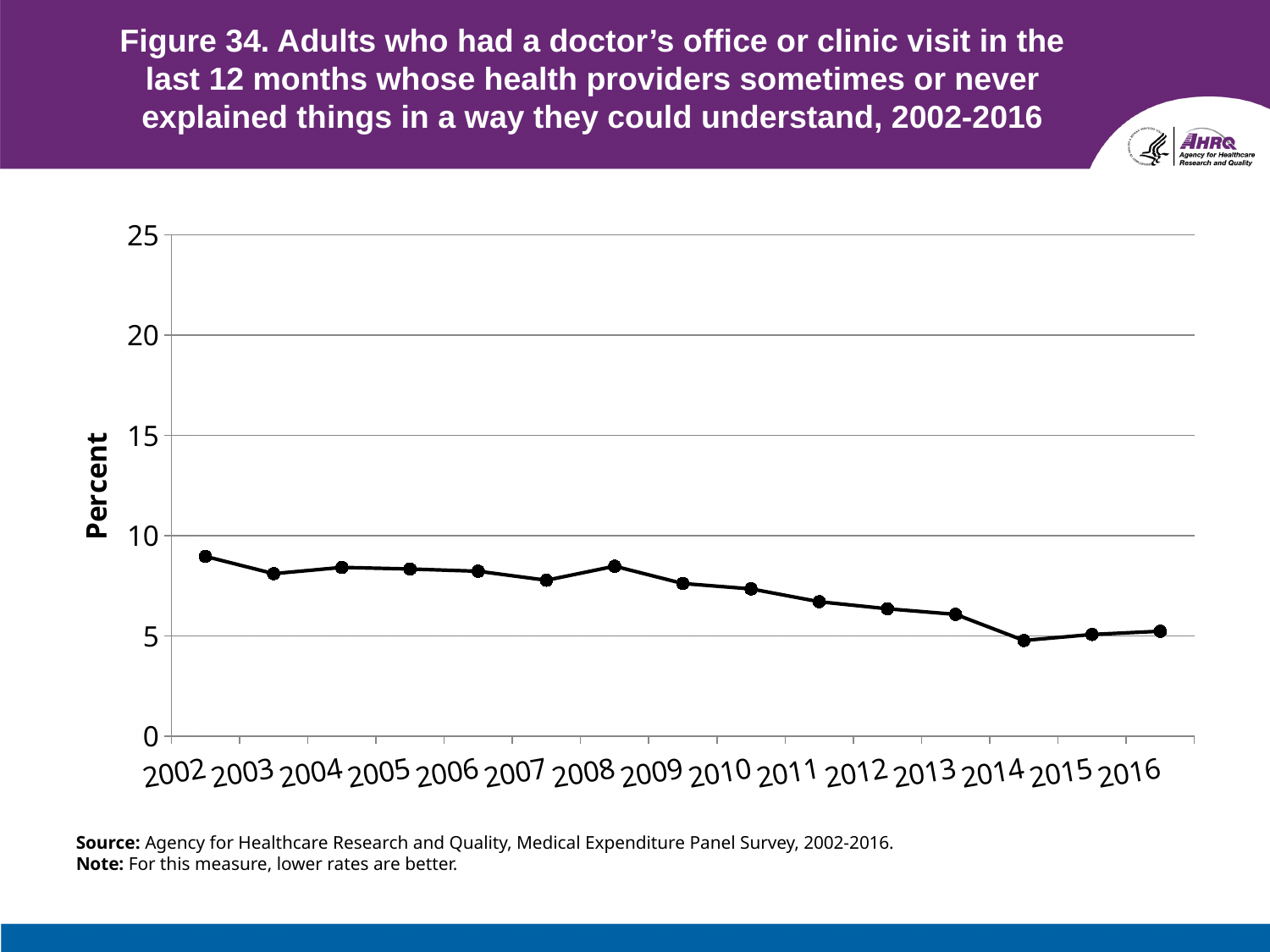
What is the first year shown on the horizontal axis? 2002 What is the label on the vertical axis? Percent Is the value for 2002 greater or less than 10? less Which year has the highest value on the chart? 2002 Overall, do the values rise or fall from 2002 to 2016? fall Is the value for 2013 greater or less than 5? greater Which is larger, the value for 2008 or the value for 2014? 2008 How many years (data points) are plotted on the chart? 15 Is the value for 2008 greater or less than 10? less What kind of chart is shown on the slide? line chart Which is larger, the value for 2002 or the value for 2016? 2002